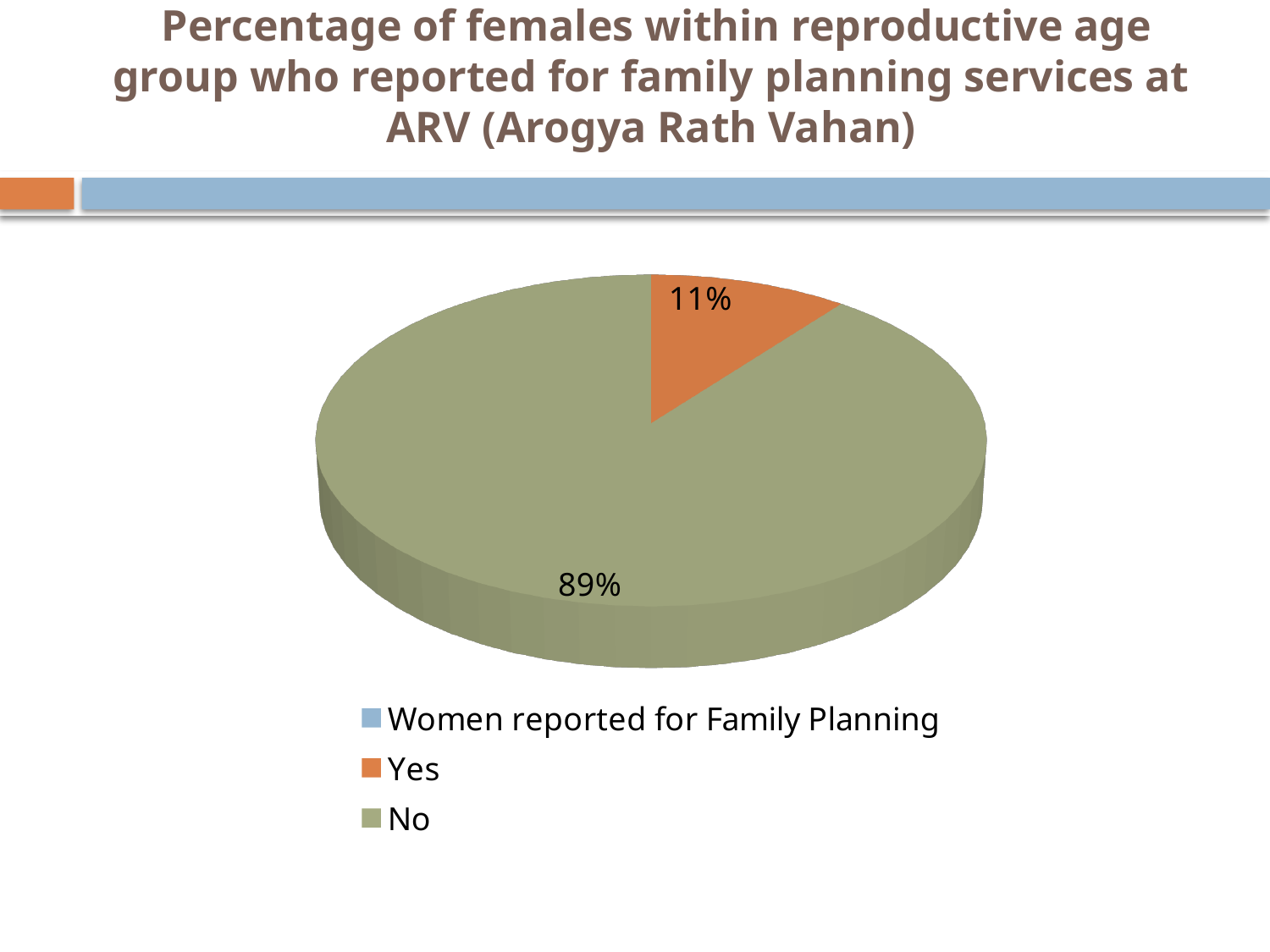
What is the difference in percentage points between the "No" slice and the "Yes" slice? 78 What percentage of the pie is labelled for the "Yes" slice? 11% What kind of chart is shown on the slide? pie chart How many slices with data labels does the pie have? 2 Which slice of the pie is the largest? No Which slice of the pie is the smallest? Yes What colour is the "Yes" slice of the pie? orange Which is larger, the "Yes" slice or the "No" slice? No What percentage of the pie is labelled for the "No" slice? 89% How many entries does the legend list? 3 What is the first entry listed in the legend? Women reported for Family Planning